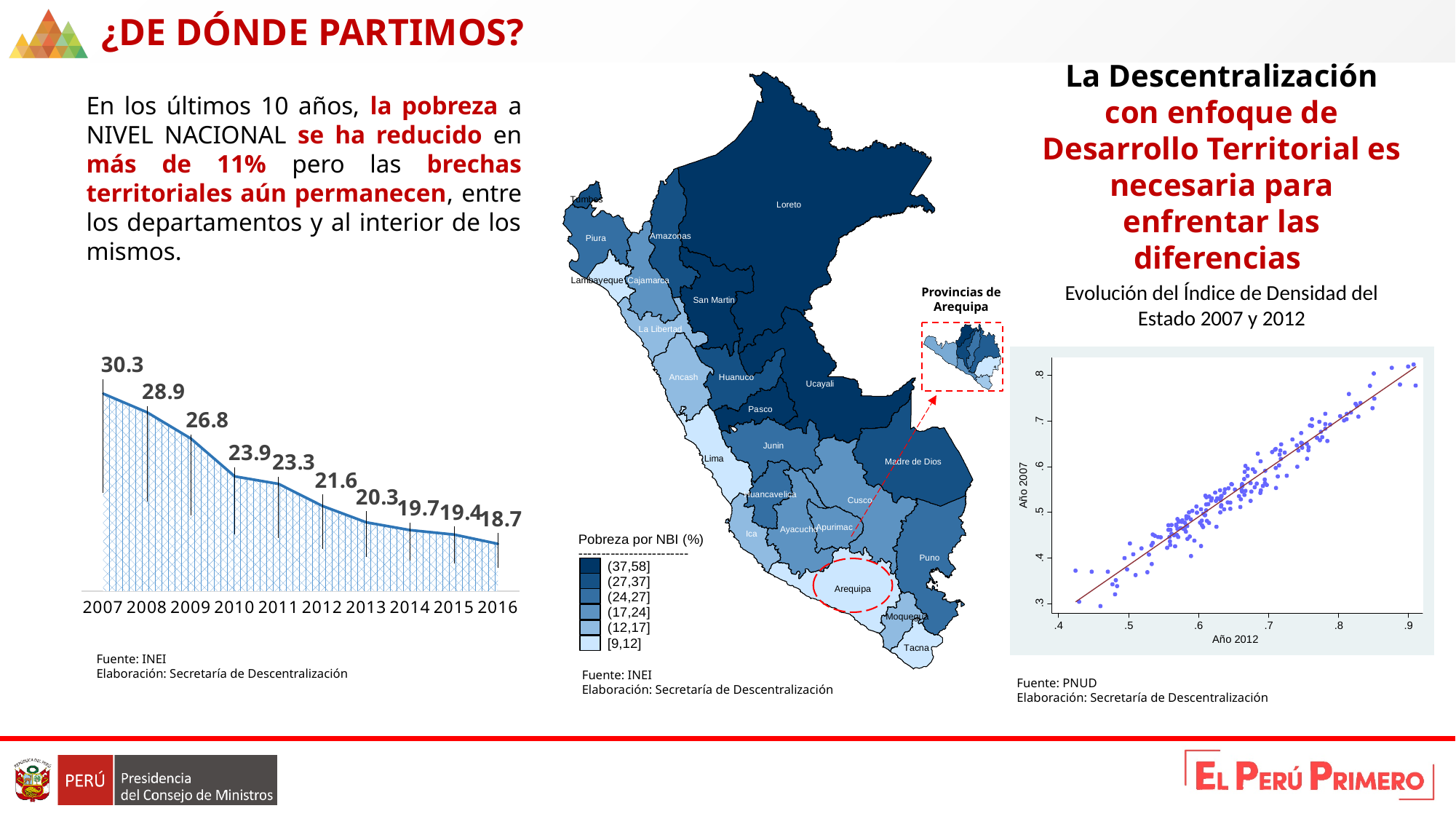
In the line chart on the left of the slide, which is larger, the value for 2011 or the value for 2013? 2011 Do the values in the line chart on the left of the slide rise or fall from 2007 to 2016? fall In the line chart on the left of the slide, what is the value for 2012? 21.6 In the line chart on the left of the slide, what is the difference between the values for 2007 and 2016? 11.6 What is the label of the horizontal axis of the scatter plot on the right of the slide? Año 2012 In the line chart on the left of the slide, which year has the lowest value? 2016 In the line chart on the left of the slide, what is the value for 2007? 30.3 In the line chart on the left of the slide, which year has the highest value? 2007 How many years are plotted in the line chart on the left of the slide? 10 In the line chart on the left of the slide, what is the value for 2016? 18.7 In the line chart on the left of the slide, what is the difference between the values for 2009 and 2010? 2.9 What kind of chart is the chart on the right of the slide titled 'Evolución del Índice de Densidad del Estado 2007 y 2012'? scatter plot